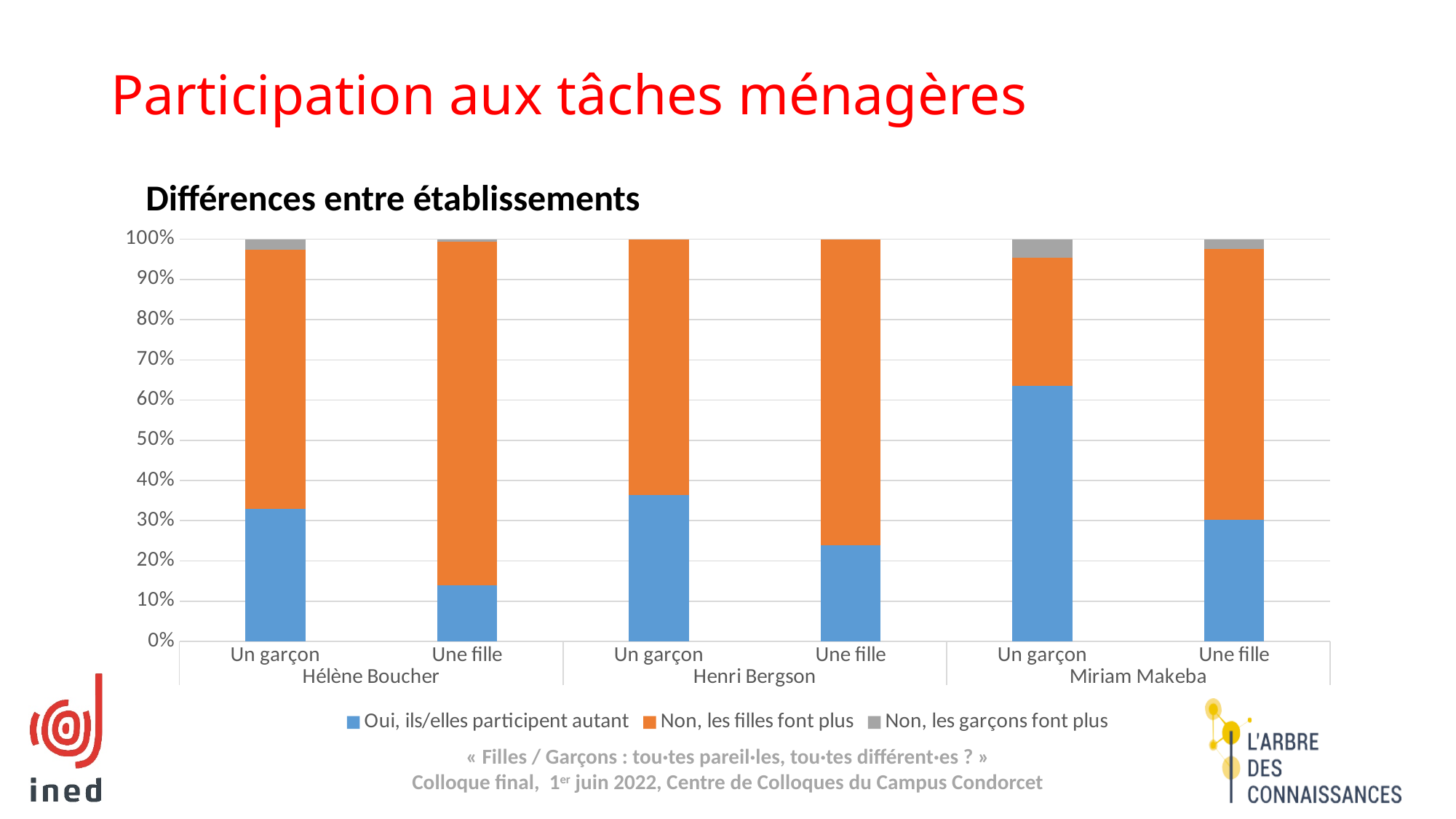
At Miriam Makeba, which has the larger 'Oui, ils/elles participent autant' segment, Un garçon or Une fille? Un garçon Which bar has the smallest 'Oui, ils/elles participent autant' segment? Une fille, Hélène Boucher How many series does the legend list? 3 Which colour represents 'Non, les garçons font plus' in the legend? grey How many bars are plotted in the chart? 6 Is the 'Oui, ils/elles participent autant' share for Un garçon at Henri Bergson greater or less than 30%? greater What is the title of the chart? Différences entre établissements Is the 'Oui, ils/elles participent autant' share for Une fille at Hélène Boucher greater or less than 20%? less Is the 'Oui, ils/elles participent autant' share for Un garçon at Miriam Makeba greater or less than 50%? greater Which bar has the largest 'Oui, ils/elles participent autant' segment? Un garçon, Miriam Makeba What kind of chart is shown on the slide? stacked bar chart How many establishments are shown on the x axis? 3